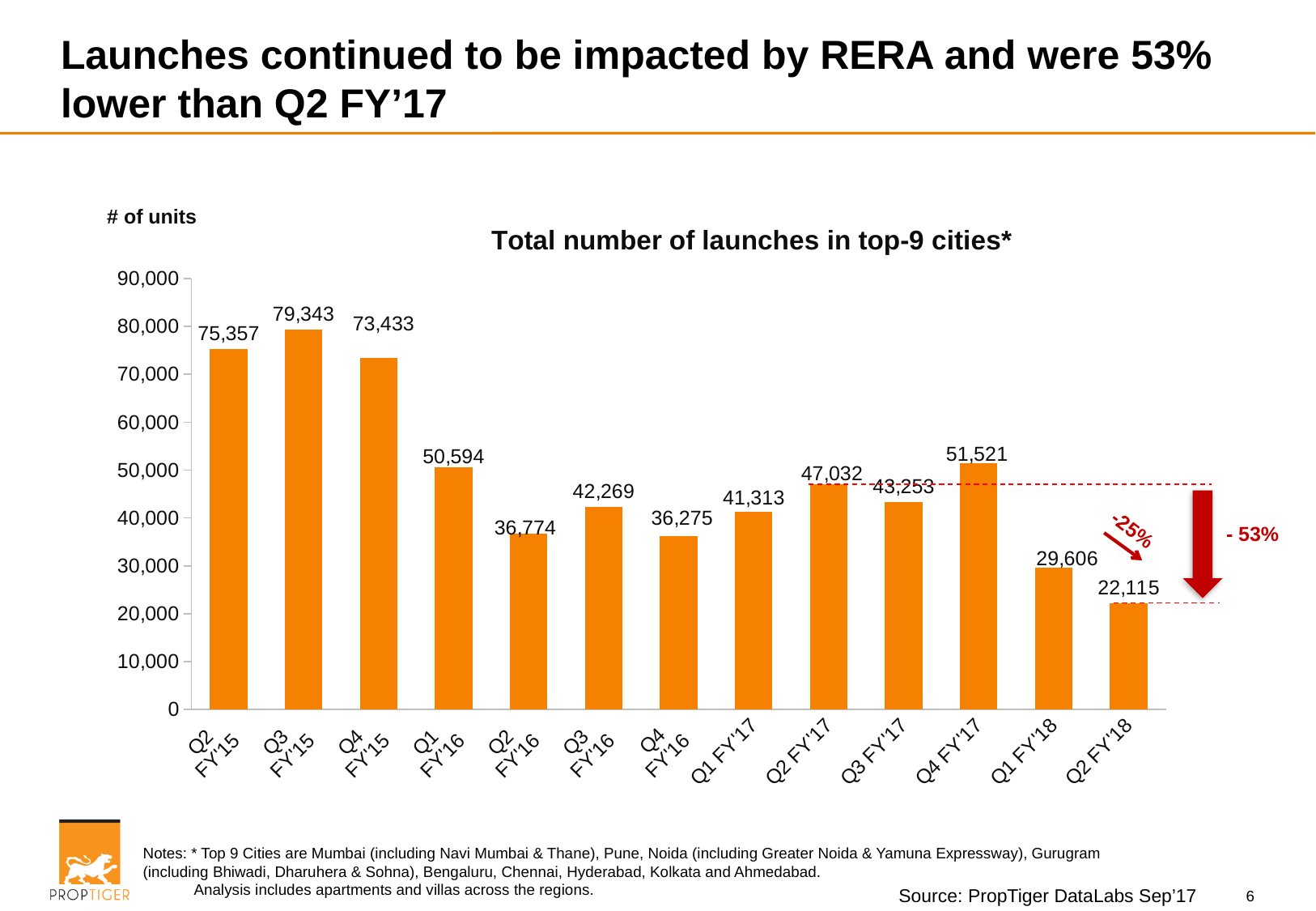
What is the total number of launches in Q2 FY'18? 22,115 Is the value for Q1 FY'18 greater or less than 30,000? less What is the total number of launches in Q4 FY'17? 51,521 What type of chart is shown on the slide? Bar chart Which quarter has the highest number of launches? Q3 FY'15 What is the difference in launches between Q2 FY'17 and Q2 FY'18? 24,917 What is the difference in launches between Q1 FY'18 and Q2 FY'18? 7,491 Which quarter has the lowest number of launches? Q2 FY'18 How many quarters are plotted in the chart? 13 What is the title of the chart? Total number of launches in top-9 cities* Which quarter had more launches, Q3 FY'16 or Q4 FY'16? Q3 FY'16 What is the total number of launches in Q1 FY'16? 50,594